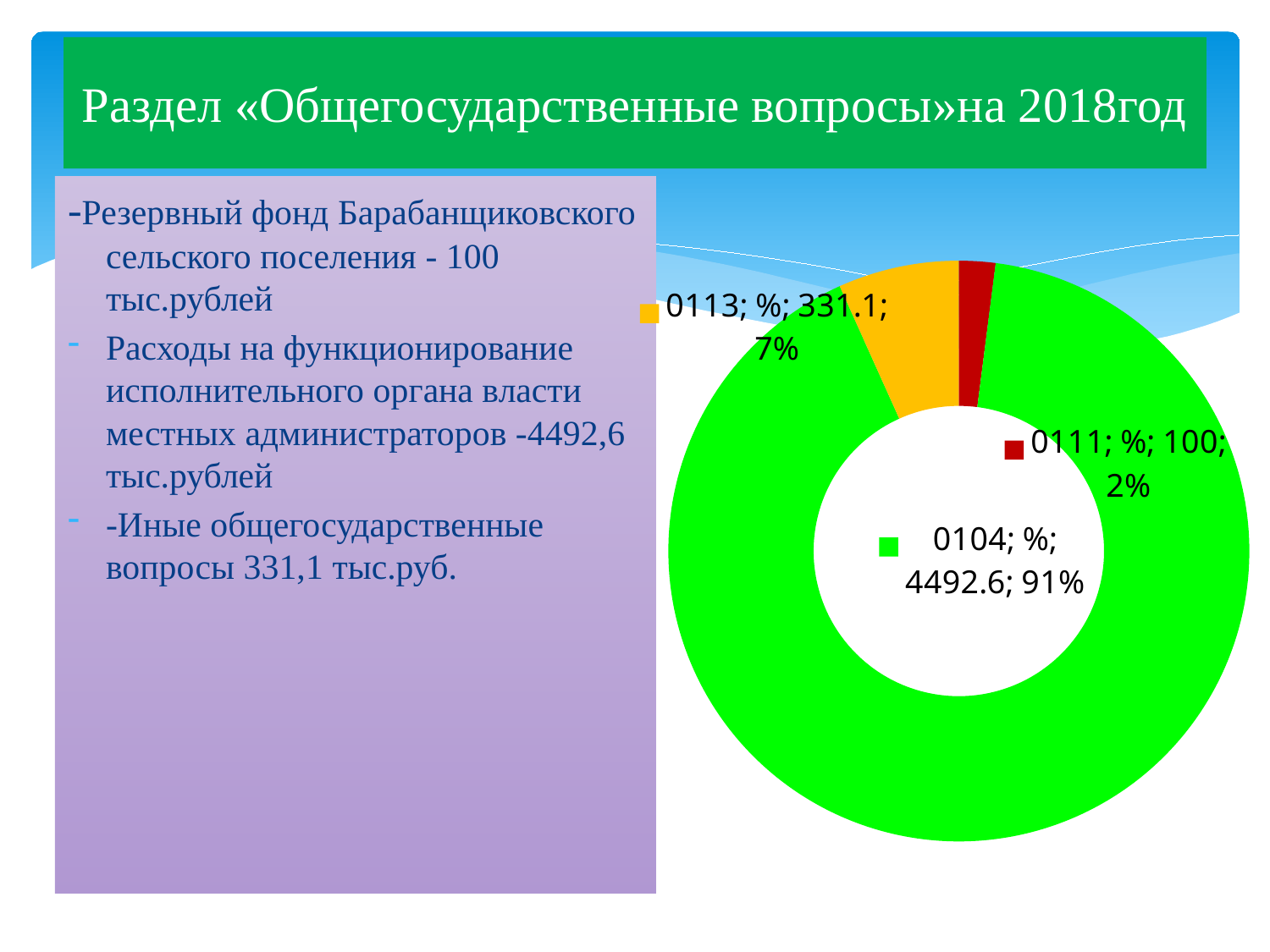
Which is larger, the value for 0113 or the value for 0111? 0113 What is the difference between the values for 0113 and 0111? 231.1 What is the value shown for category 0113? 331.1 What share of the doughnut does category 0104 represent? 91% What is the value shown for category 0104? 4492.6 How many slices does the doughnut chart have? 3 What share of the doughnut does category 0113 represent? 7% Which category has the largest slice? 0104 What kind of chart is shown on the slide? doughnut chart Which category has the smallest slice? 0111 What share of the doughnut does category 0111 represent? 2% What is the value shown for category 0111? 100